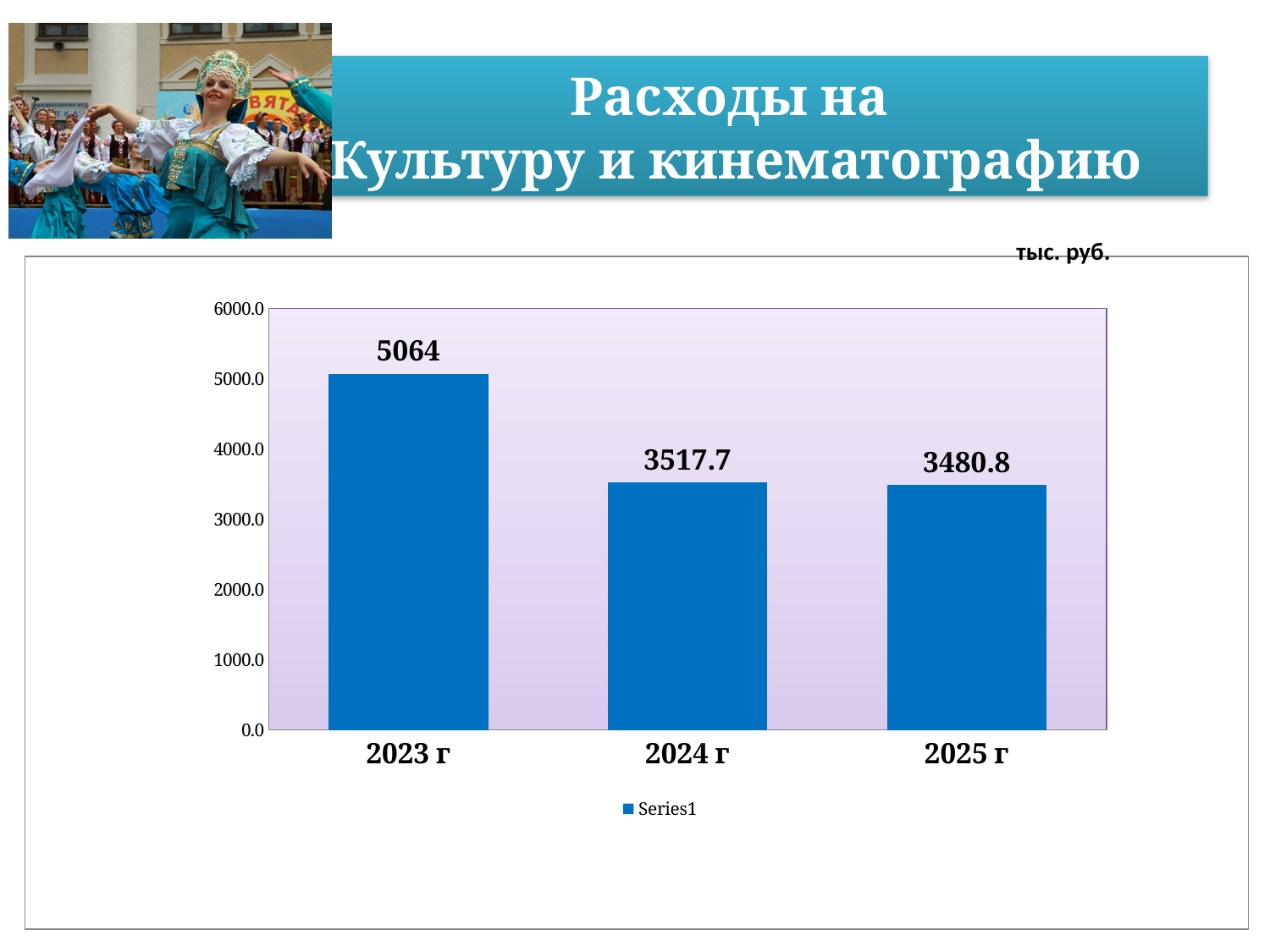
What kind of chart is shown on the slide? bar chart Do the values rise or fall from 2023 г to 2025 г? fall What is the difference between the values for 2023 г and 2024 г? 1546.3 Which is larger, the value for 2023 г or the value for 2025 г? 2023 г What is the difference between the values for 2024 г and 2025 г? 36.9 What is the value for 2023 г? 5064 Is the value for 2024 г greater or less than 4000.0? less How many categories are shown on the x axis? 3 Which year has the highest value? 2023 г What is the value for 2025 г? 3480.8 Which year has the lowest value? 2025 г What is the value for 2024 г? 3517.7